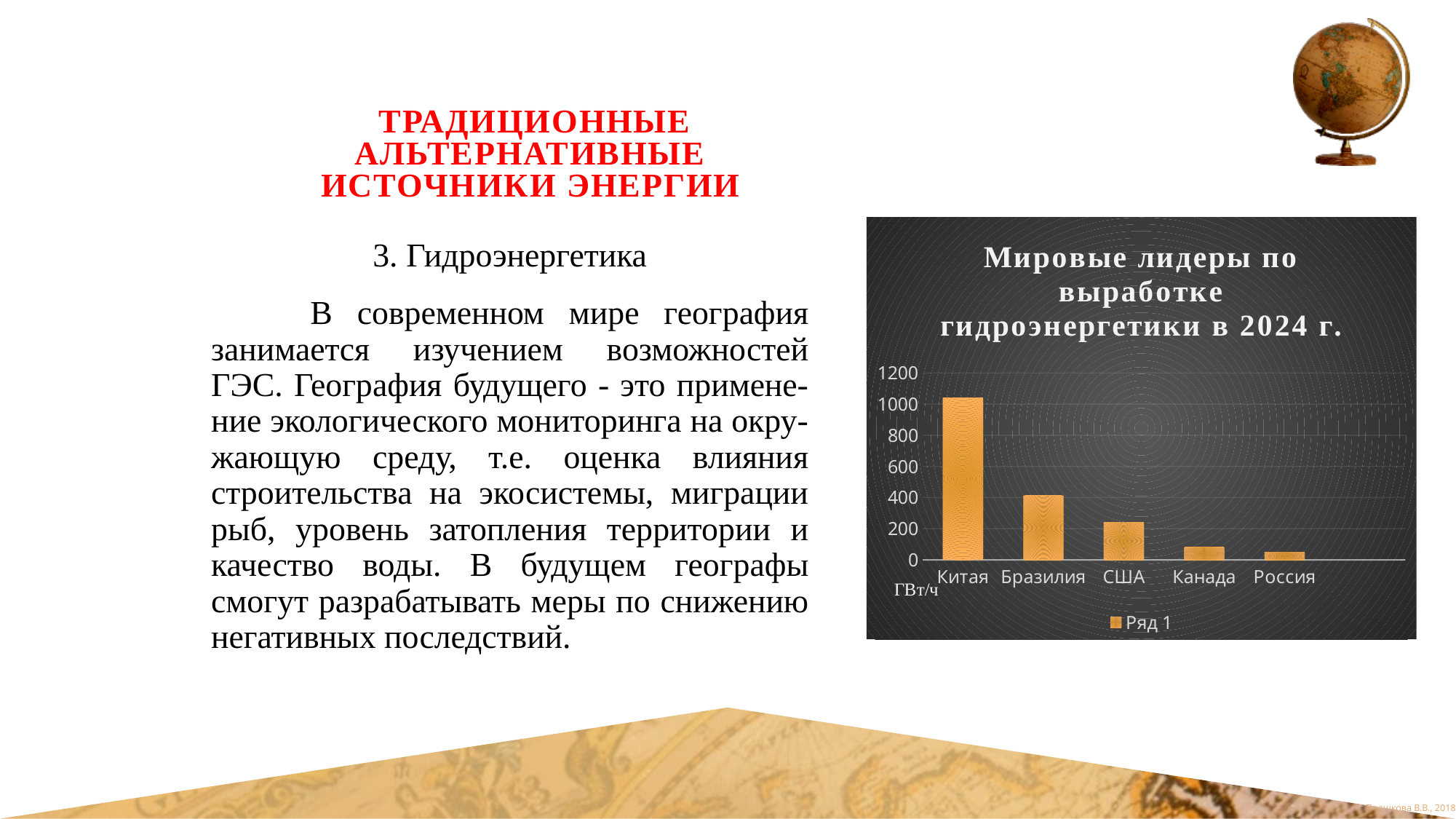
Which country has the highest hydropower output in the chart? Китая What is the title of the chart? Мировые лидеры по выработке гидроэнергетики в 2024 г. Is the value for США greater or less than 400? less How many series does the chart legend list? 1 What kind of chart is shown on the slide? bar chart Do the bar values rise or fall from left to right along the x axis? fall Which has the larger value, Бразилия or США? Бразилия Is the value for Канада greater or less than 200? less How many countries are shown on the x axis of the chart? 5 Is the value for Бразилия greater or less than 600? less Which country has the lowest hydropower output in the chart? Россия